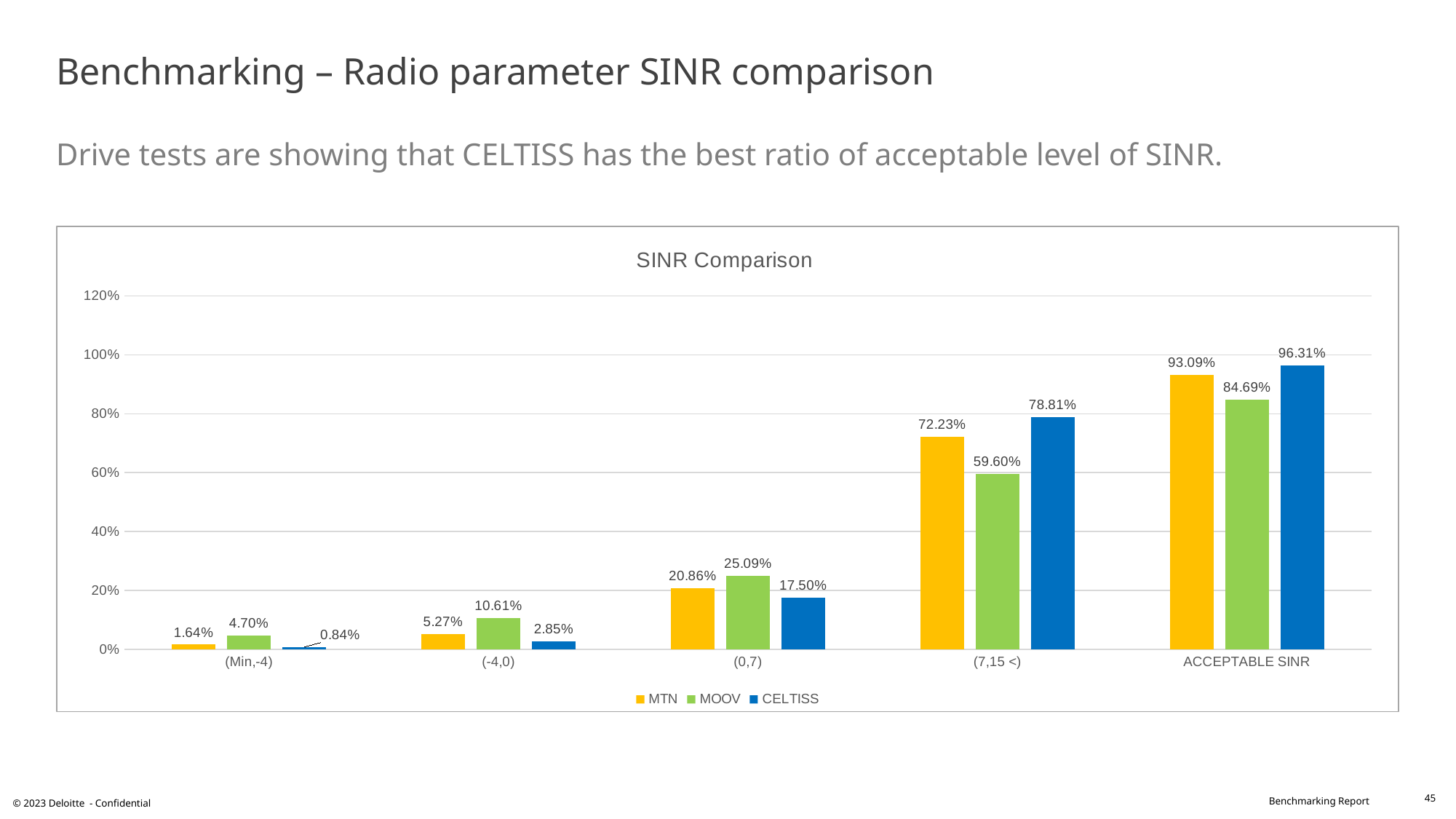
Which series has the highest value in the ACCEPTABLE SINR category? CELTISS In the (-4,0) category, which is larger: the MOOV value or the MTN value? MOOV What is the value for MTN in the (7,15 <) category? 72.23% What is the title of the chart? SINR Comparison Which series has the lowest value in the (Min,-4) category? CELTISS What is the value for CELTISS in the ACCEPTABLE SINR category? 96.31% What is the difference between the MTN and MOOV values in the (7,15 <) category? 12.63% How many categories are shown on the x axis? 5 How many series does the legend list? 3 Is the value for MOOV in the (7,15 <) category greater or less than 60%? less What is the value for MOOV in the (0,7) category? 25.09% What kind of chart is shown on the slide? Bar chart